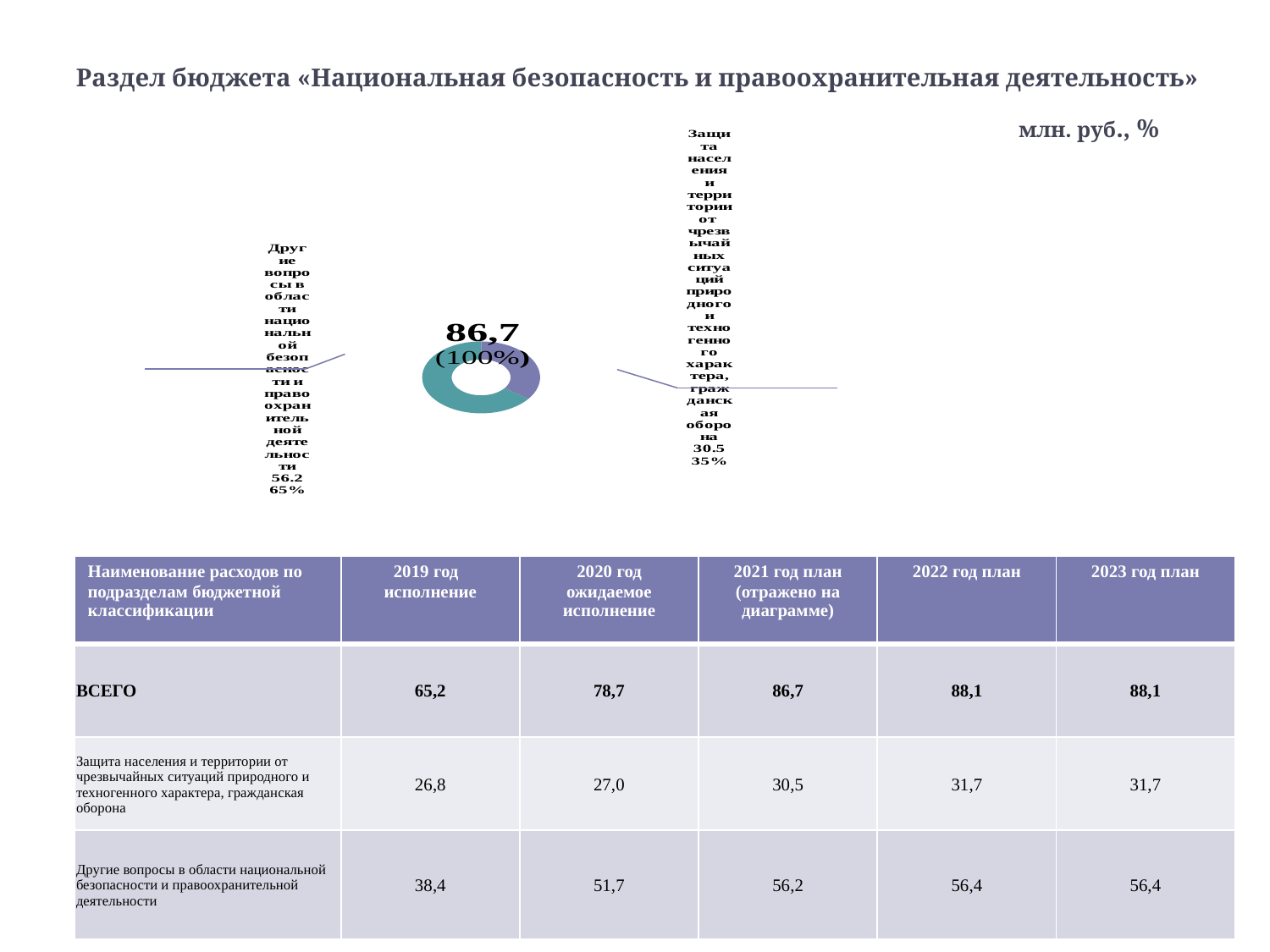
Which is larger: the slice for "Другие вопросы..." or the slice for "Защита населения..."? Другие вопросы в области национальной безопасности и правоохранительной деятельности What kind of chart is shown on the slide? doughnut chart What unit is indicated for the chart in the top right of the slide? млн. руб., % What total value is printed in the centre of the doughnut chart? 86,7 (100%) What value is shown for the slice "Защита населения и территории от чрезвычайных ситуаций природного и техногенного характера, гражданская оборона"? 30.5 What is the difference between the values of the two slices in the doughnut chart (56.2 and 30.5)? 25.7 How many slices does the doughnut chart have? 2 What share of the doughnut does "Другие вопросы в области национальной безопасности и правоохранительной деятельности" take? 65% What share of the doughnut does "Защита населения и территории от чрезвычайных ситуаций природного и техногенного характера, гражданская оборона" take? 35% Which slice of the doughnut chart is the largest? Другие вопросы в области национальной безопасности и правоохранительной деятельности What value is shown for the slice "Другие вопросы в области национальной безопасности и правоохранительной деятельности"? 56.2 Which slice of the doughnut chart is the smallest? Защита населения и территории от чрезвычайных ситуаций природного и техногенного характера, гражданская оборона